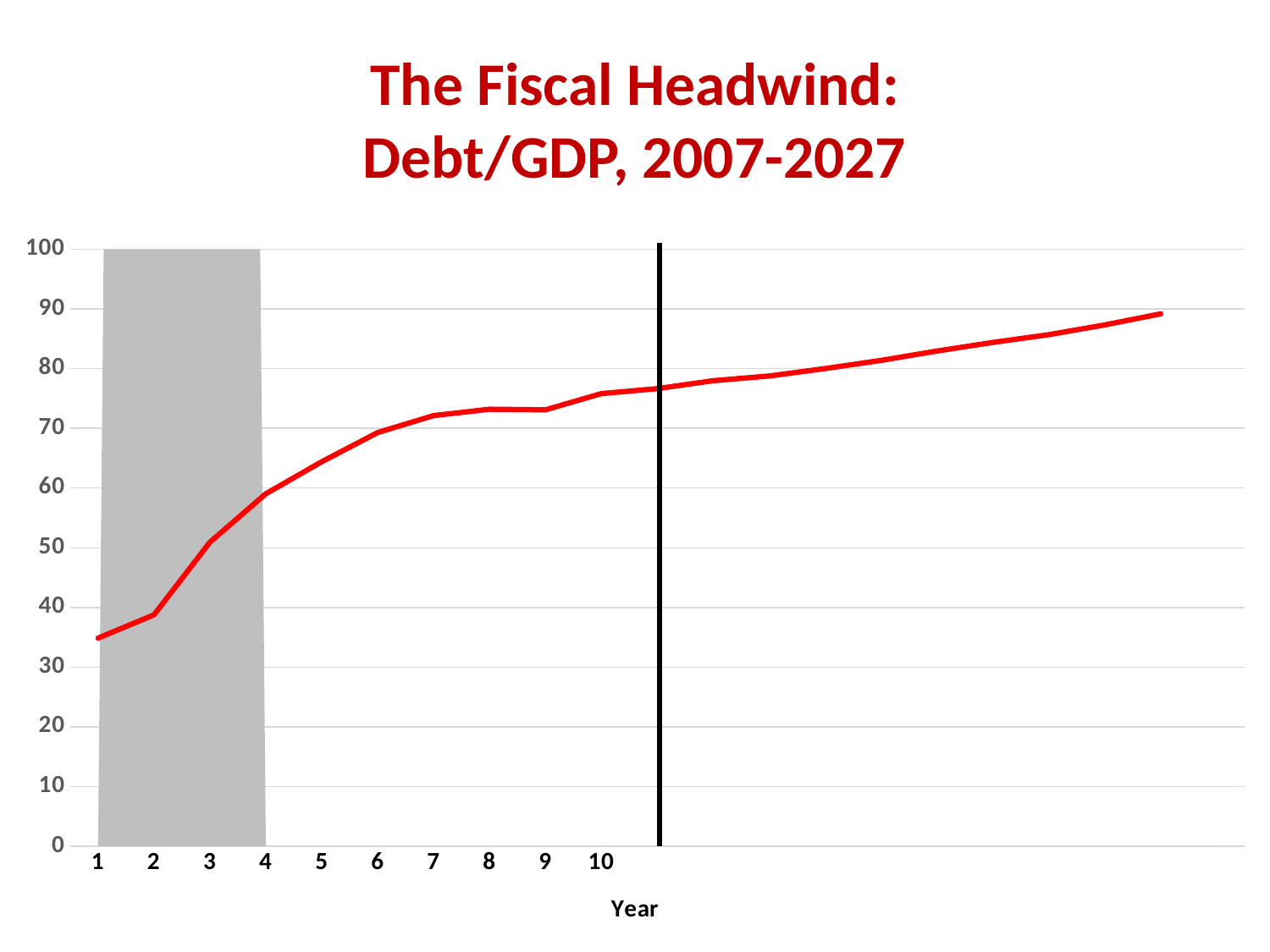
What kind of chart is shown on the slide? line chart Is the value for year 10 greater or less than 80? less Which is larger, the value for year 1 or the value for year 10? year 10 Do the values rise or fall as the year increases along the x axis? rise Is the value for year 10 greater or less than 70? greater What is the label on the x axis? Year Which labeled year has the lowest value? 1 Which labeled year has the highest value? 10 Is the value for year 7 greater or less than 70? greater What is the title of the chart? The Fiscal Headwind: Debt/GDP, 2007-2027